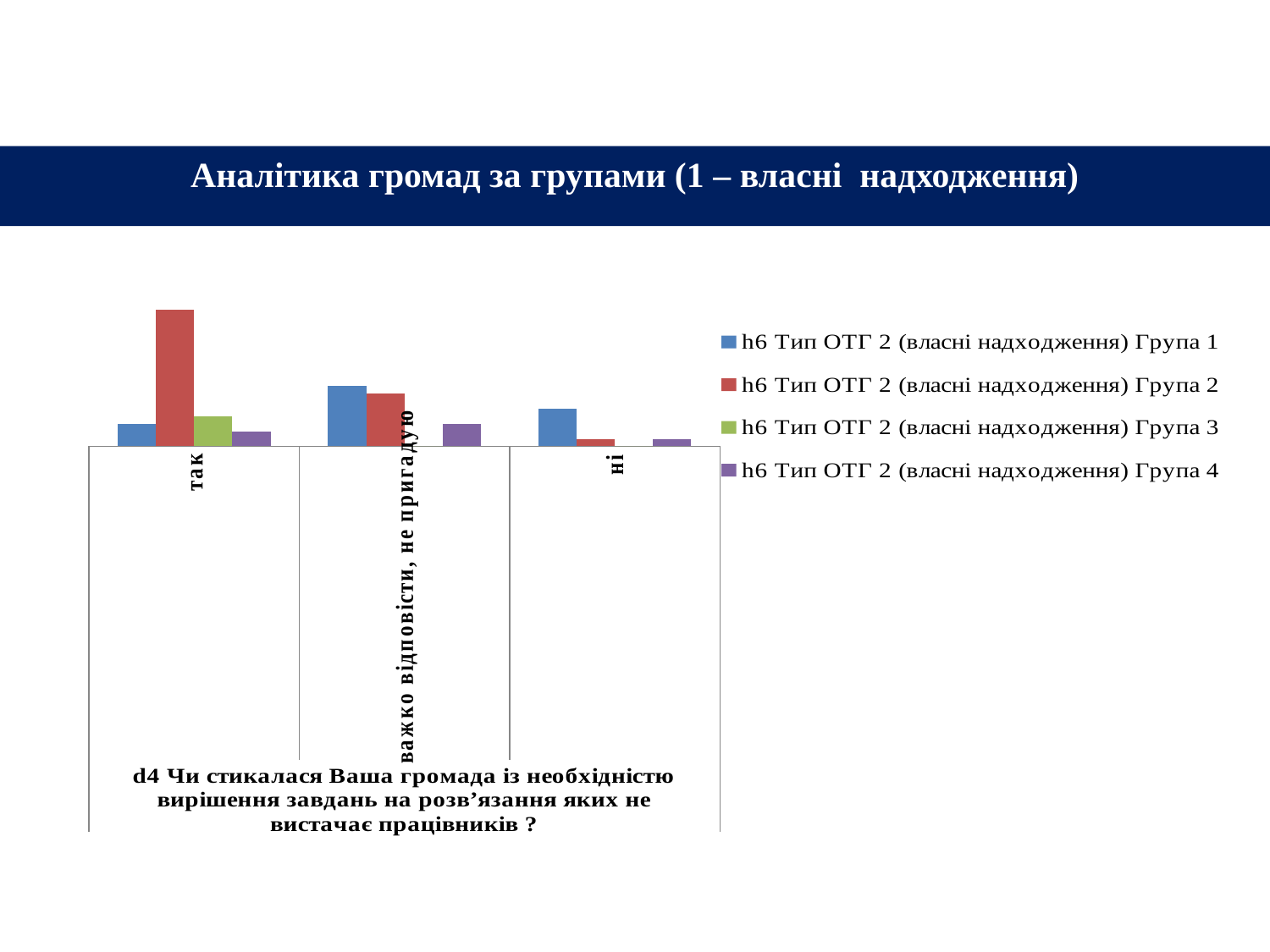
How many categories are shown on the x axis of the chart? 3 Do the bars for Група 2 rise or fall moving from "так" to "ні" along the x axis? fall In the category "ні", which group has the highest bar? h6 Тип ОТГ 2 (власні надходження) Група 1 In the category "так", which group has the lowest bar? h6 Тип ОТГ 2 (власні надходження) Група 4 What colour are the bars for Група 3 in the chart? green How many series does the chart's legend list? 4 What is the title of the slide? Аналітика громад за групами (1 – власні надходження) In the category "так", which group has the highest bar? h6 Тип ОТГ 2 (власні надходження) Група 2 What kind of chart is shown on the slide? bar chart In the category "ні", which is larger: the bar for Група 1 or the bar for Група 2? Група 1 In the category "так", which is larger: the bar for Група 2 or the bar for Група 3? Група 2 For Група 2, which category has the larger bar: "так" or "ні"? так